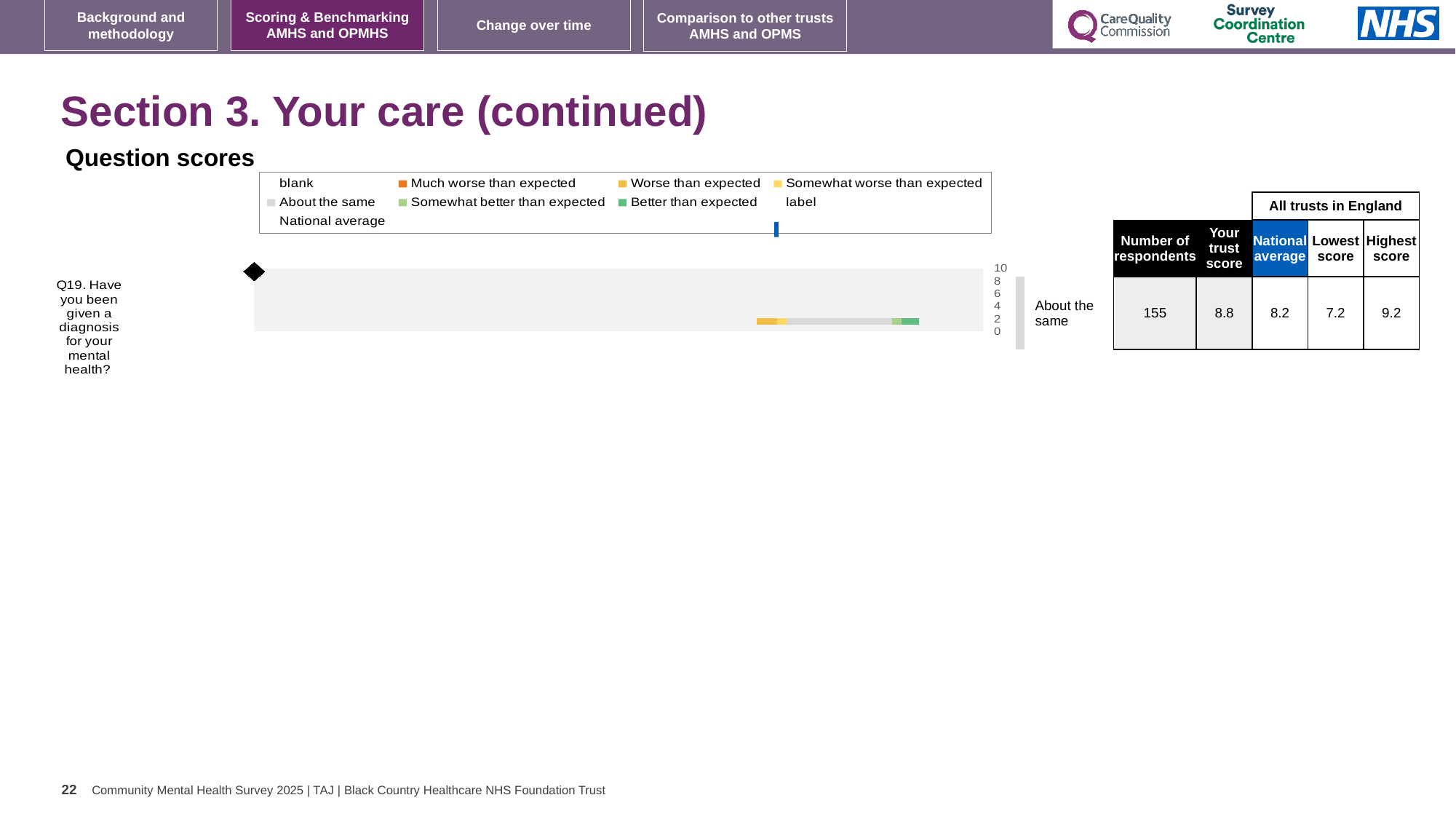
How many respondents answered Q19? 155 How many survey questions are plotted on the chart? 1 What is the highest score among all trusts in England for Q19? 9.2 What is the maximum value shown on the chart's vertical axis? 10 What category label is shown beside the chart for Q19? About the same What is the difference between the trust's score and the national average for Q19? 0.6 Which question is shown on the chart? Q19. Have you been given a diagnosis for your mental health? What is the national average score for Q19? 8.2 What is the difference between the highest and lowest scores among all trusts for Q19? 2.0 What is the lowest score among all trusts in England for Q19? 7.2 What is the trust's score for Q19 according to the table next to the chart? 8.8 Which is larger for Q19: the trust's score or the national average? The trust's score